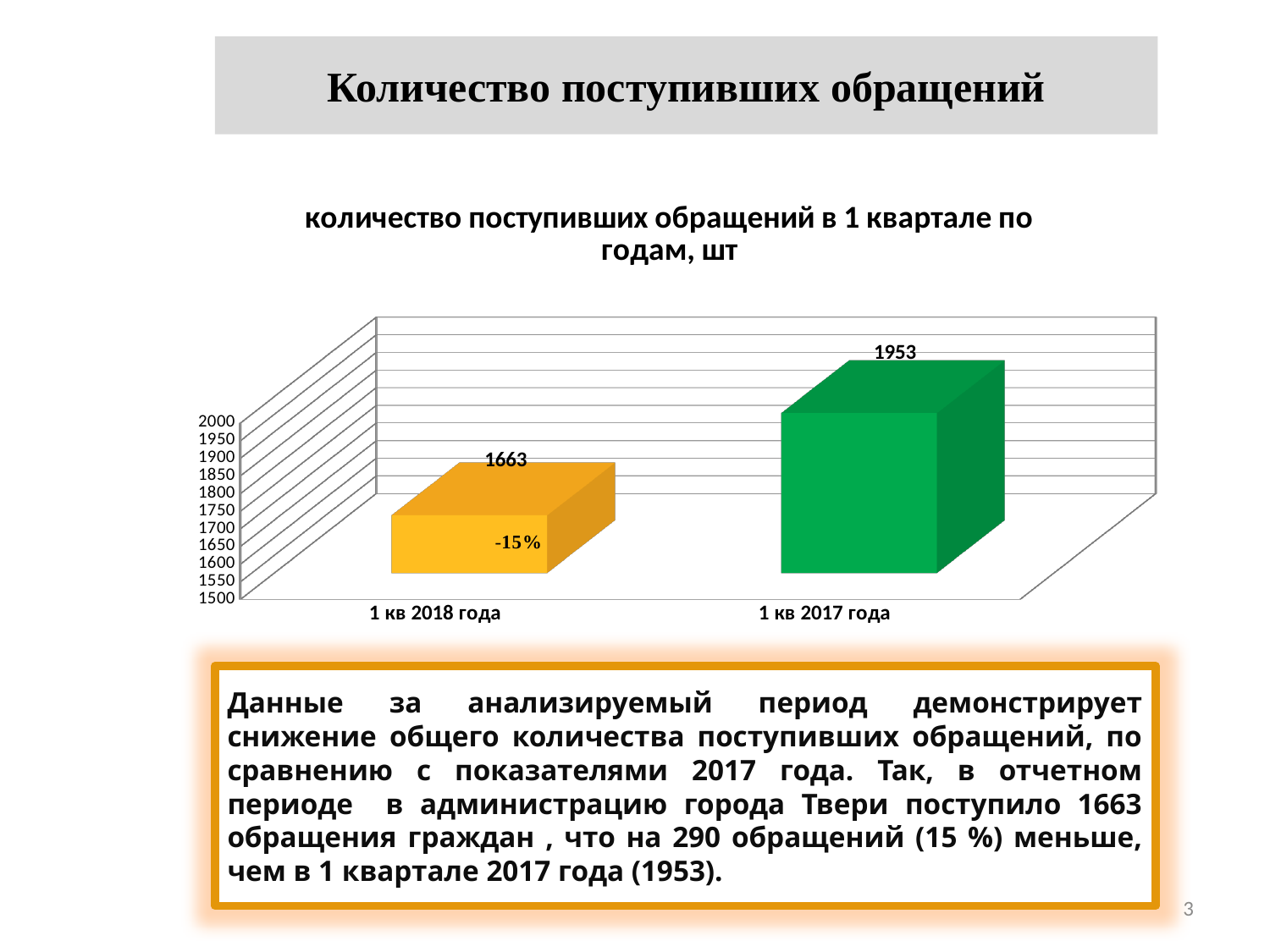
What is the value for 1 кв 2017 года? 1953 Is the value for 1 кв 2017 года greater or less than 1900? greater What is the difference between the values for 1 кв 2017 года and 1 кв 2018 года? 290 Which category has the highest value? 1 кв 2017 года What kind of chart is shown on the slide? bar chart What is the value for 1 кв 2018 года? 1663 What is the title of the chart? количество поступивших обращений в 1 квартале по годам, шт Which is larger, the value for 1 кв 2018 года or the value for 1 кв 2017 года? 1 кв 2017 года Which category has the lowest value? 1 кв 2018 года What percentage change label is printed on the bar for 1 кв 2018 года? -15% Is the value for 1 кв 2018 года greater or less than 1800? less How many categories are shown on the x axis? 2